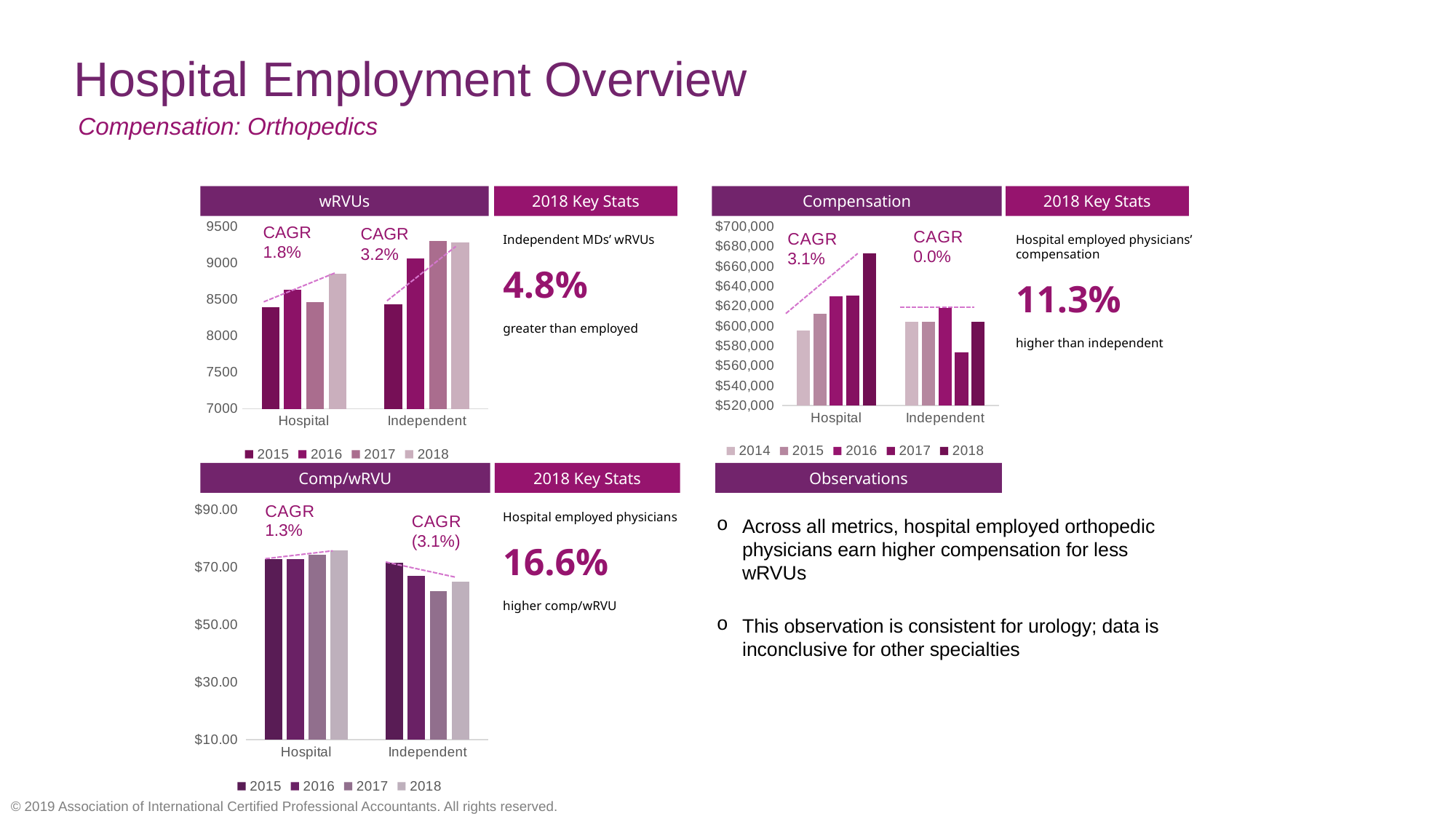
In the Compensation chart, is the value for Hospital in 2018 greater or less than $660,000? greater In the Compensation chart, what is the CAGR shown for Independent? 0.0% In the wRVUs chart, what is the CAGR shown for Independent? 3.2% What kind of chart is the Comp/wRVU chart? Bar chart In the Comp/wRVU chart, what is the CAGR shown for Independent? (3.1%) In the wRVUs chart, what is the CAGR shown for Hospital? 1.8% How many series does the legend of the Compensation chart list? 5 In the Compensation chart, which category and year has the lowest bar? Independent, 2017 How many series does the legend of the wRVUs chart list? 4 In the Compensation chart, which category and year has the highest bar? Hospital, 2018 In the Comp/wRVU chart, is the value for Independent in 2017 greater or less than $70.00? less In the wRVUs chart, is the value for Hospital in 2015 greater or less than 8500? less